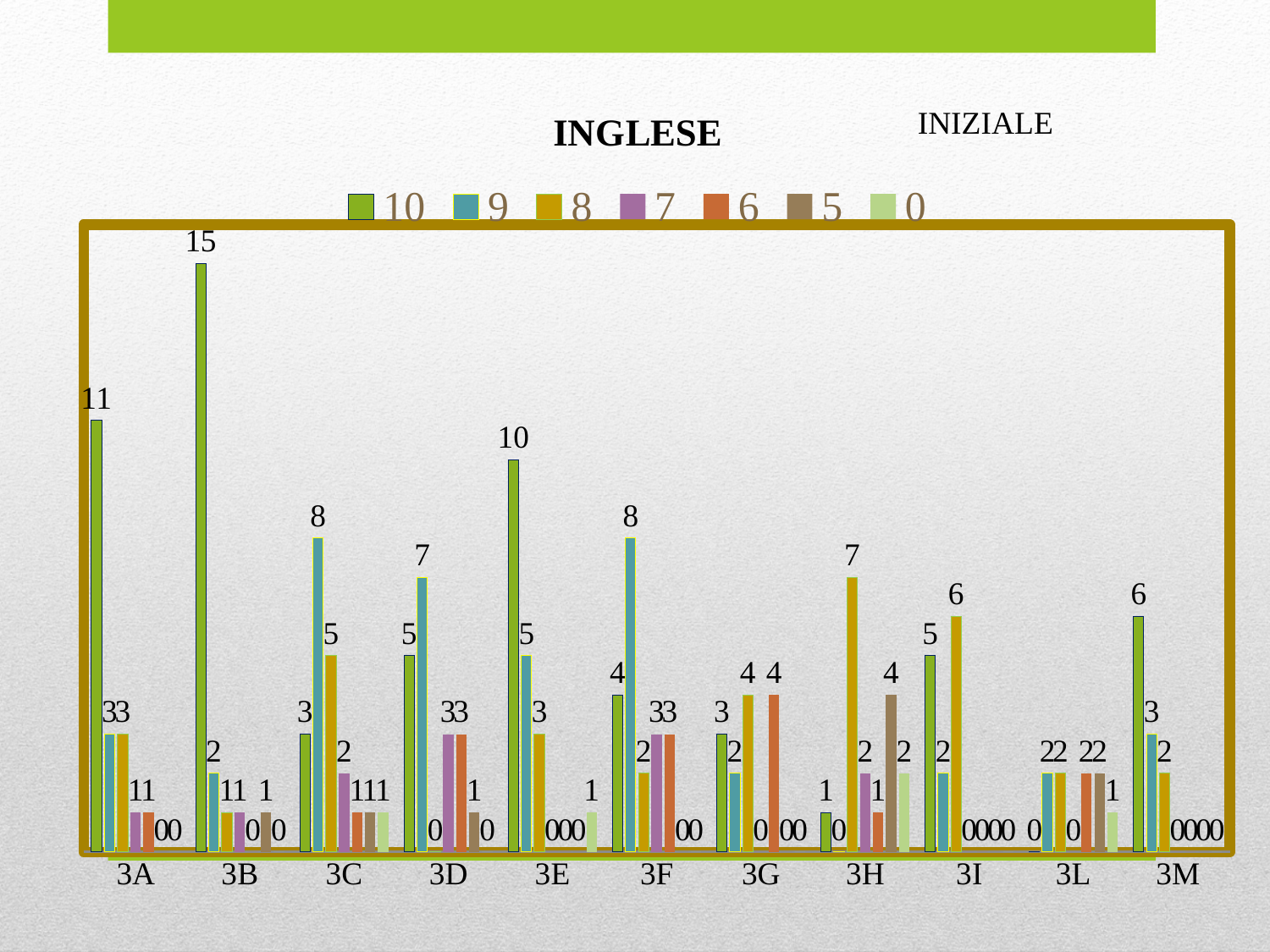
What is the value of the "5" series for class 3H? 4 Which class has the highest value in the "10" series? 3B What is the value of the "9" series for class 3C? 8 Which is larger: the "8" series value for 3I or the "8" series value for 3M? 3I What kind of chart is shown? bar chart What is the value of the "8" series for class 3H? 7 What is the title of the chart? INGLESE What is the difference between the "10" series values for 3B and 3A? 4 What is the value of the "10" series for class 3B? 15 What is the value of the "10" series for class 3E? 10 How many series does the legend list? 7 How many classes are shown on the x axis? 11